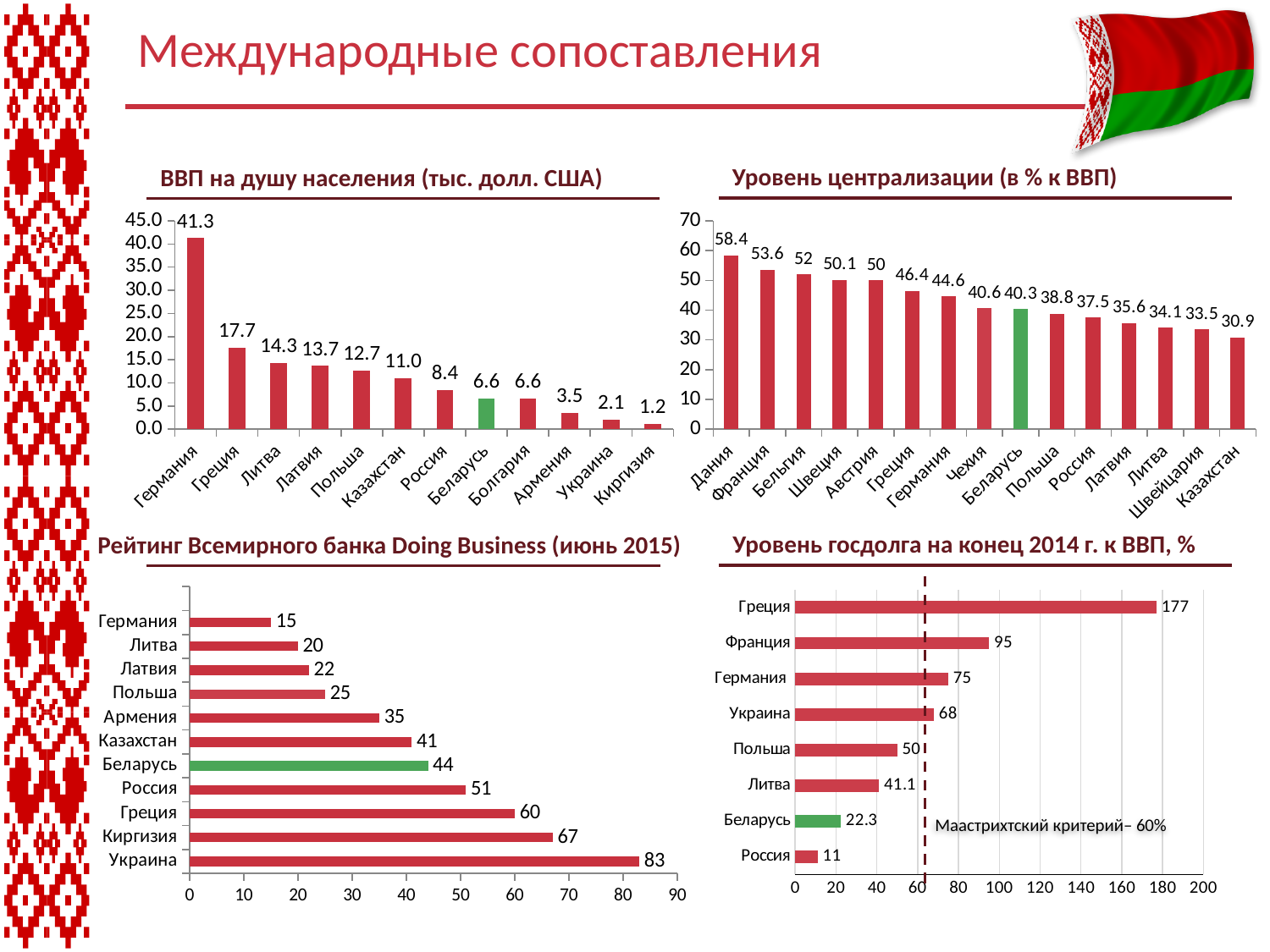
In the chart 'ВВП на душу населения (тыс. долл. США)', what is the value for Беларусь? 6.6 In the chart 'Уровень централизации (в % к ВВП)', which is larger: Беларусь or Польша? Беларусь In the chart 'Рейтинг Всемирного банка Doing Business (июнь 2015)', what is the value for Беларусь? 44 In the chart 'Рейтинг Всемирного банка Doing Business (июнь 2015)', which country has the highest value? Украина In the chart 'Уровень централизации (в % к ВВП)', which country has the lowest value? Казахстан In the chart 'ВВП на душу населения (тыс. долл. США)', which country has the highest value? Германия In the chart 'ВВП на душу населения (тыс. долл. США)', what is the difference between Германия and Греция? 23.6 In the chart 'Уровень централизации (в % к ВВП)', what is the value for Дания? 58.4 How many countries are shown in the chart 'ВВП на душу населения (тыс. долл. США)'? 12 In the chart 'Уровень госдолга на конец 2014 г. к ВВП, %', what is the value for Греция? 177 What type of chart is 'Уровень госдолга на конец 2014 г. к ВВП, %'? bar chart How many countries are shown in the chart 'Уровень централизации (в % к ВВП)'? 15